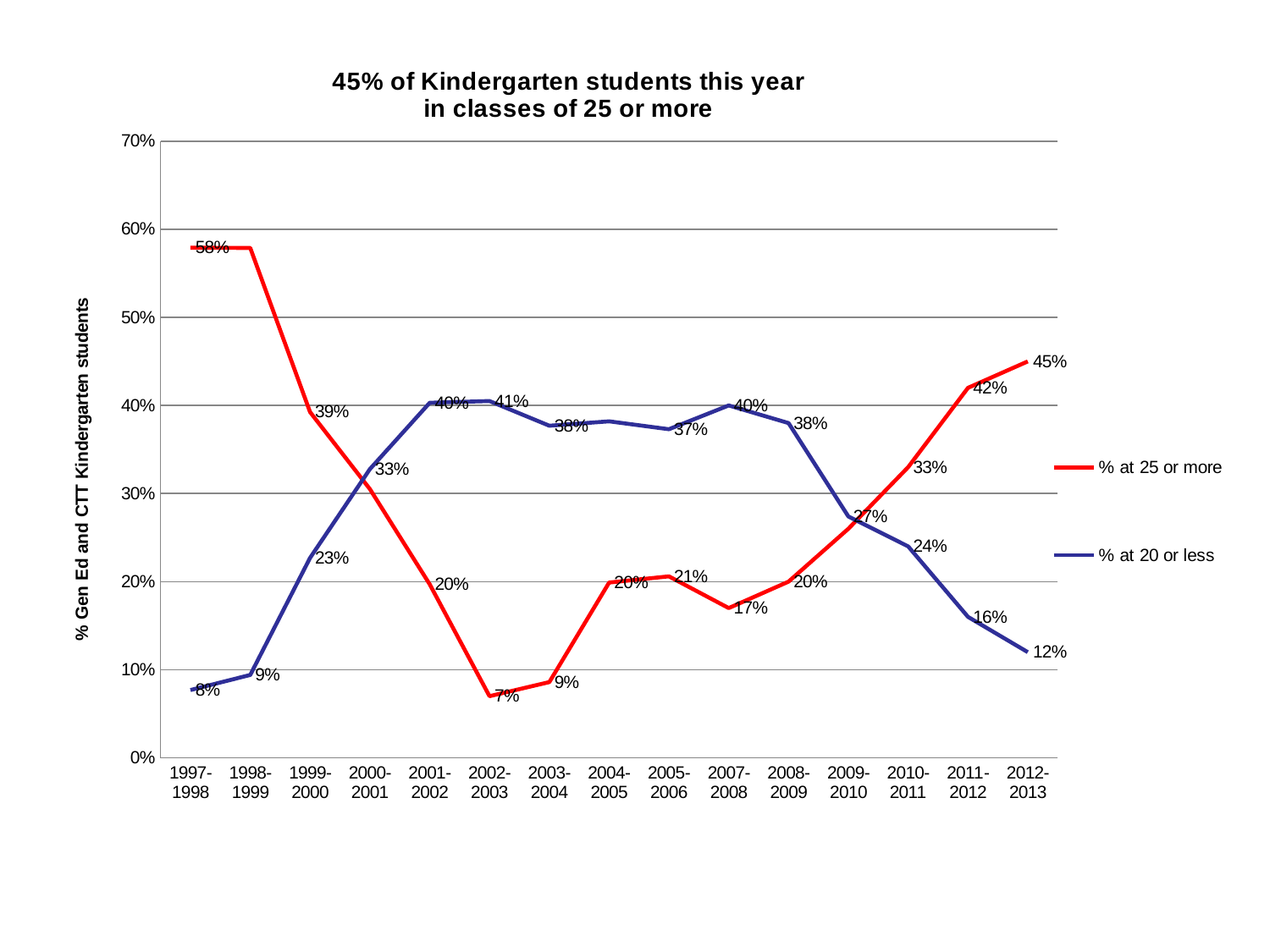
What is the value of the "% at 20 or less" series for 2012-2013? 12% In which school year is the "% at 20 or less" series at its lowest? 1997-1998 What is the value of the "% at 25 or more" series for 2012-2013? 45% How many series does the legend list? 2 In which school year is the "% at 25 or more" series at its lowest? 2002-2003 What kind of chart is shown on the slide? Line chart In 2002-2003, which series has the larger value: "% at 25 or more" or "% at 20 or less"? % at 20 or less How many school years are shown on the x axis? 15 Is the value of the "% at 25 or more" series for 1998-1999 greater or less than 50%? greater What is the value of the "% at 20 or less" series for 2011-2012? 16% What is the difference between the "% at 25 or more" and "% at 20 or less" values in 2012-2013? 33 percentage points What is the value of the "% at 25 or more" series for 2002-2003? 7%